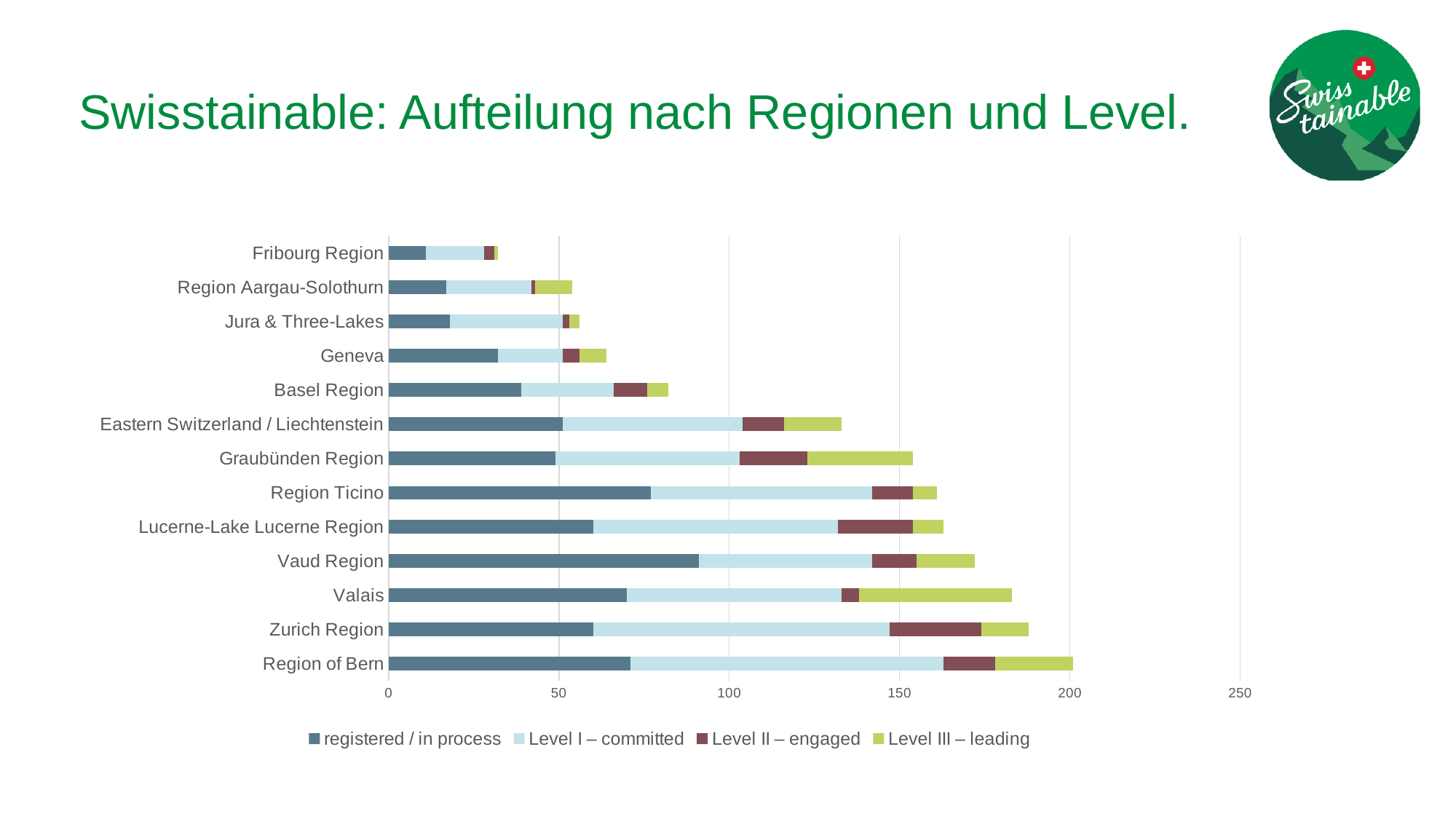
Which has the larger total bar, Basel Region or Geneva? Basel Region Which region has the shortest total bar? Fribourg Region How many regions are listed on the chart? 13 Which has the larger total bar, Region of Bern or Zurich Region? Region of Bern What is the title of the slide? Swisstainable: Aufteilung nach Regionen und Level. Which region has the longest total bar? Region of Bern What kind of chart is shown on the slide? Bar chart Is the total value for Basel Region greater or less than 100? less Is the total value for Fribourg Region greater or less than 50? less Is the total value for Eastern Switzerland / Liechtenstein greater or less than 150? less How many series does the legend list? 4